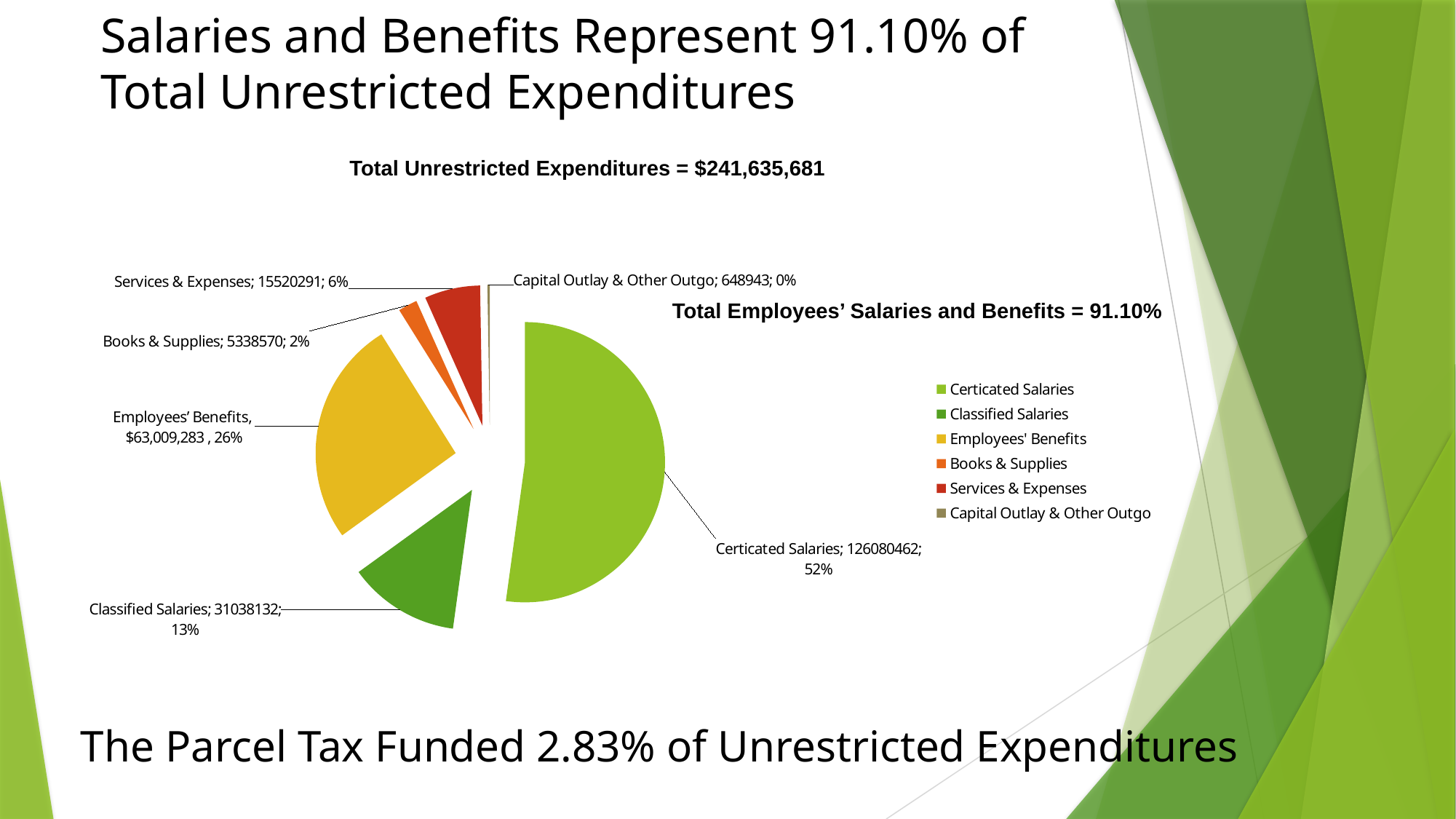
How many entries does the legend list? 6 Which category has the largest slice of the pie? Certicated Salaries Which category has the smallest slice of the pie? Capital Outlay & Other Outgo What share of the pie does Employees' Benefits represent? 26% What share of the pie does Books & Supplies represent? 2% What is the value shown for Capital Outlay & Other Outgo? 648943 What kind of chart is shown on the slide? pie chart What is the difference between the values for Certicated Salaries and Classified Salaries? 95042330 What is the value shown for Certicated Salaries? 126080462 What is the value shown for Classified Salaries? 31038132 What is the value shown for Services & Expenses? 15520291 What is the value shown for Employees' Benefits? $63,009,283